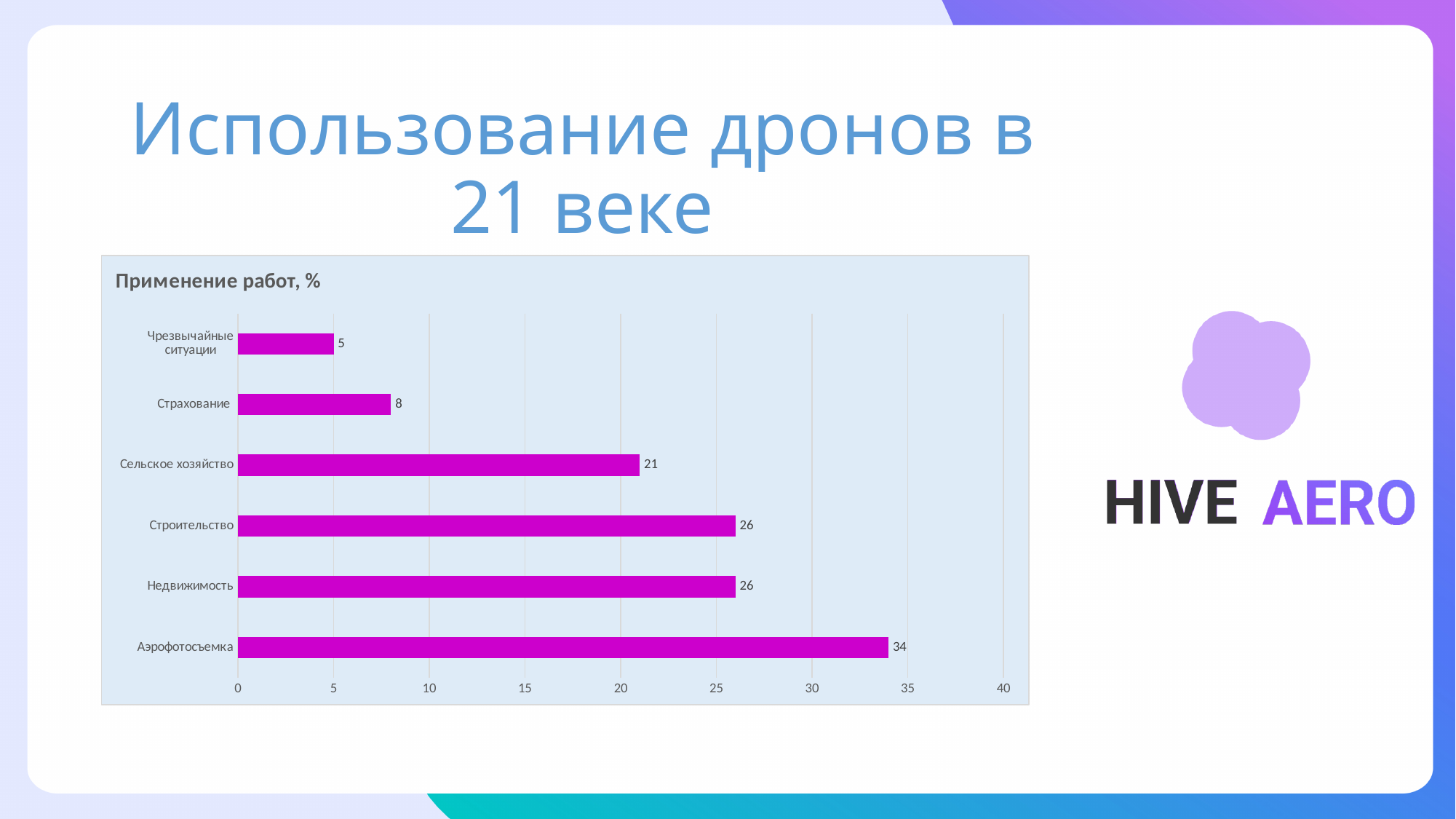
Which category has the highest value? Аэрофотосъемка What is the title of the chart? Применение работ, % Which category has the lowest value? Чрезвычайные ситуации What is the difference between the values for Сельское хозяйство and Страхование? 13 What kind of chart is shown on the slide? bar chart What is the value for Сельское хозяйство? 21 What is the value for Аэрофотосъемка? 34 What is the difference between the values for Аэрофотосъемка and Строительство? 8 What is the value for Страхование? 8 How many categories are shown in the chart? 6 What is the value for Чрезвычайные ситуации? 5 Which is larger, the value for Недвижимость or the value for Сельское хозяйство? Недвижимость